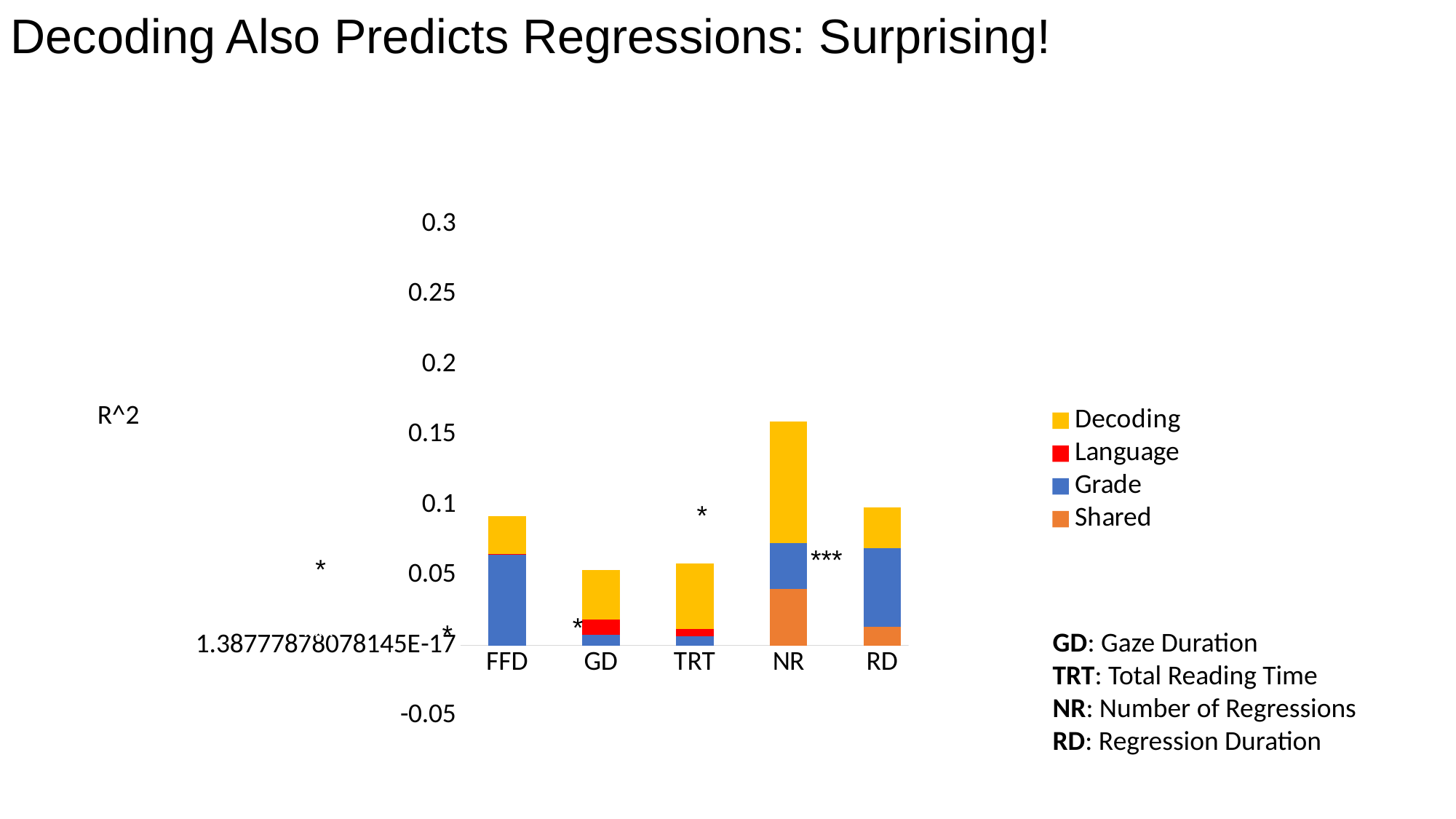
Is the total value for NR greater or less than 0.15? greater Which category has the tallest stacked bar? NR What label is shown for the vertical axis of the chart? R^2 Which colour represents the Decoding series in the legend? yellow What kind of chart is shown on the slide? stacked bar chart Which category has the largest Decoding segment? NR Which stacked bar is taller, FFD or GD? FFD How many series does the chart's legend list? 4 Is the total value for FFD greater or less than 0.1? less Which stacked bar is taller, NR or FFD? NR How many categories are shown on the x axis of the chart? 5 Is the total value for GD greater or less than 0.1? less